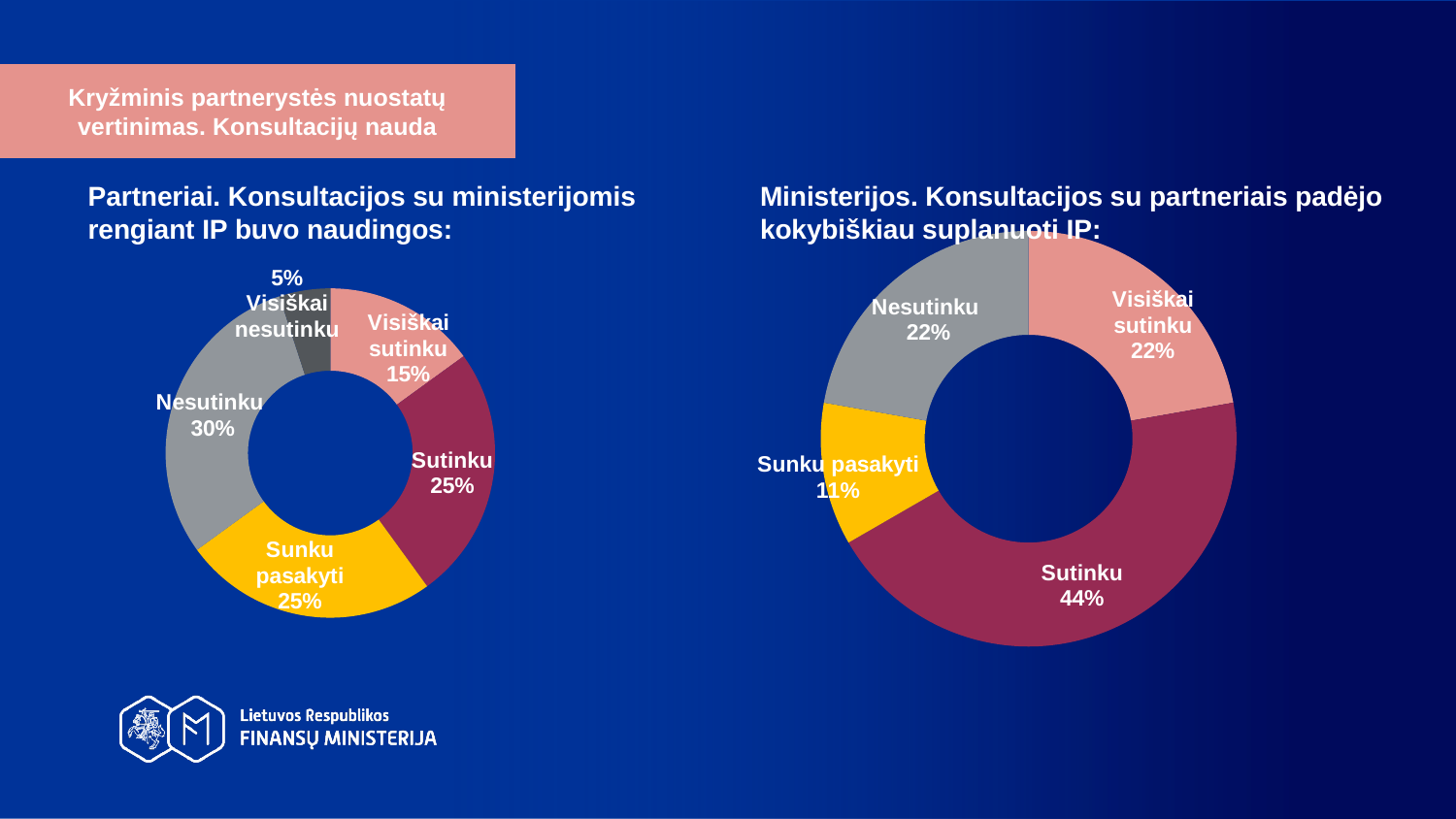
How many answer categories are shown in the right chart (Ministerijos)? 4 In the right chart (Ministerijos), which answer has the largest share? Sutinku In the left chart (Partneriai), which answer has the largest share? Nesutinku In the left chart (Partneriai), which is larger: the share for "Sutinku" or the share for "Visiškai sutinku"? Sutinku In the left chart (Partneriai), what share of respondents answered "Nesutinku"? 30% In the left chart (Partneriai), what is the difference in percentage points between "Nesutinku" and "Visiškai nesutinku"? 25 In the right chart (Ministerijos), what share of respondents answered "Sutinku"? 44% What type of chart is used on the left side of the slide (Partneriai)? Pie (donut) chart In the left chart (Partneriai), what share of respondents answered "Visiškai sutinku"? 15% In the left chart (Partneriai), which answer has the smallest share? Visiškai nesutinku In the right chart (Ministerijos), what is the difference in percentage points between "Sutinku" and "Nesutinku"? 22 In the right chart (Ministerijos), what share of respondents answered "Sunku pasakyti"? 11%